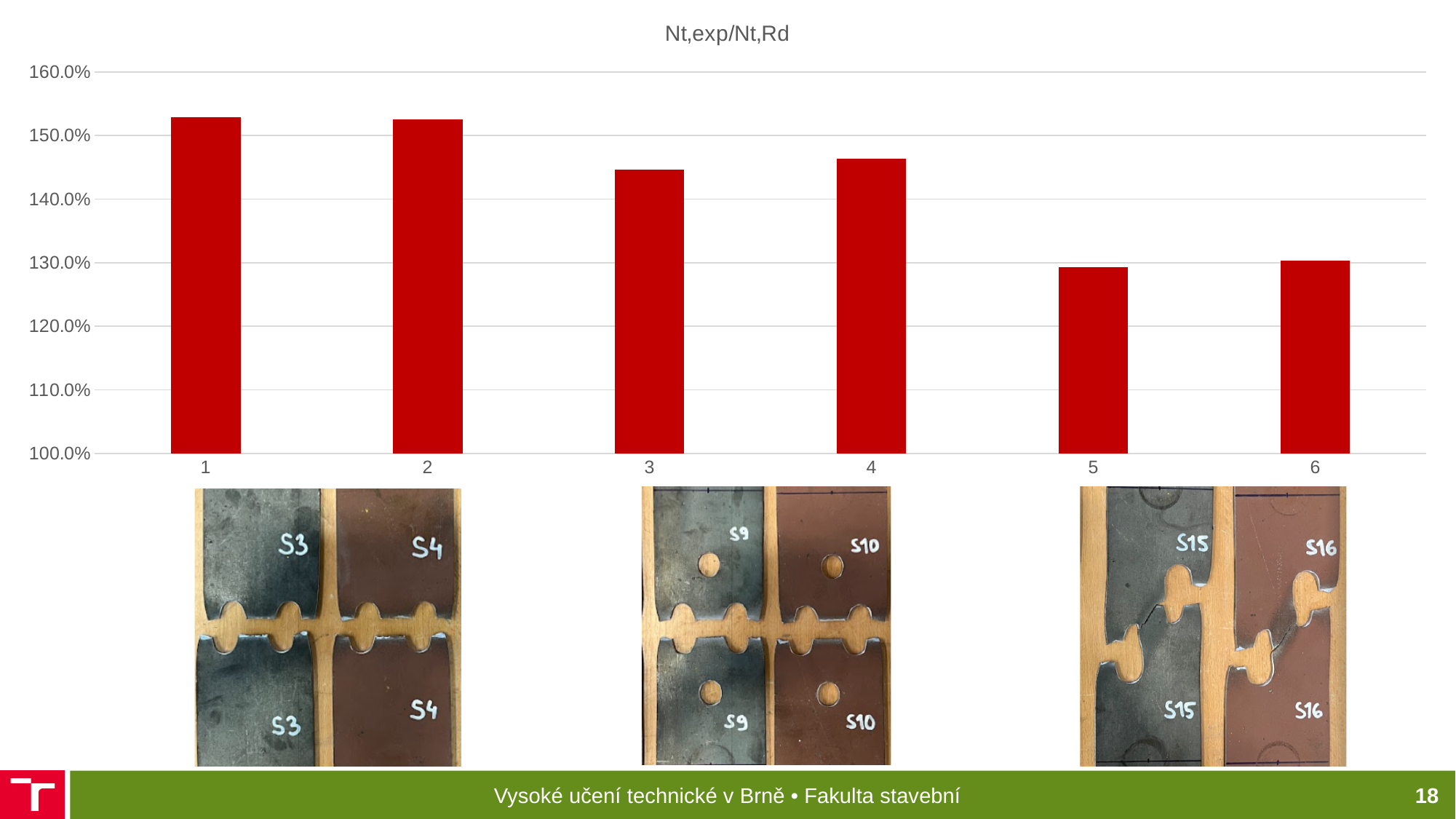
Is the value for category 6 greater or less than 140.0%? less Is the value for category 5 greater or less than 120.0%? greater How many categories are plotted on the x axis of the chart? 6 Which has the larger value, category 1 or category 5? category 1 What is the title of the chart? Nt,exp/Nt,Rd What kind of chart is shown on the slide? bar chart Is the value for category 3 greater or less than 150.0%? less Do the values generally rise or fall from category 1 to category 6? fall Which has the larger value, category 4 or category 6? category 4